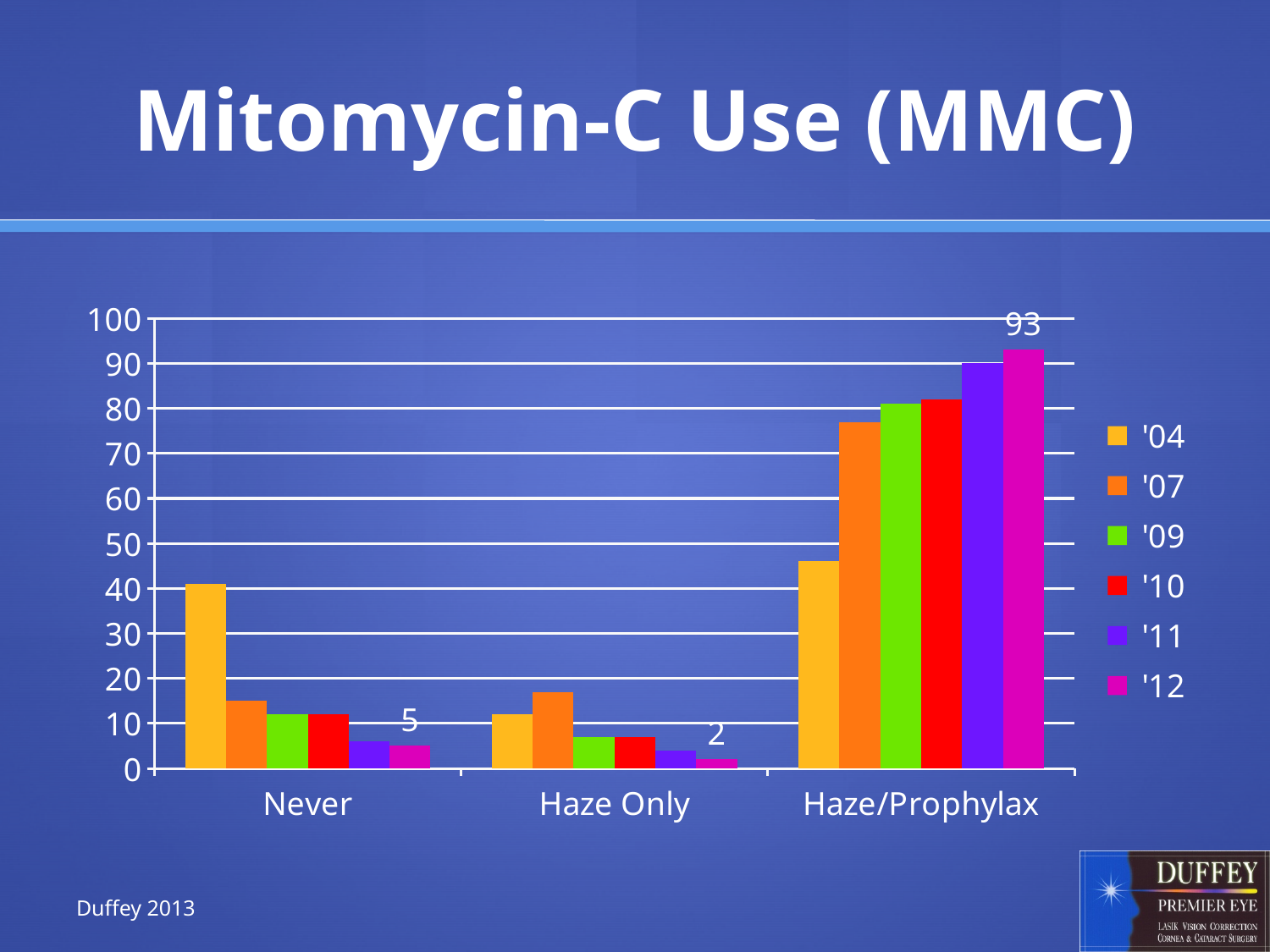
Which year has the highest value in the Haze/Prophylax category? '12 How many categories are shown on the x axis? 3 What is the difference between the '12 values for Haze/Prophylax and Never? 88 Do the values in the Haze/Prophylax category rise or fall from '04 to '12? rise Is the value for '07 in the Never category greater or less than 10? greater What is the value for '12 in the Haze/Prophylax category? 93 Which year has the highest value in the Never category? '04 What is the value for '12 in the Haze Only category? 2 Is the value for '04 in the Haze/Prophylax category greater or less than 40? greater Which year has the lowest value in the Haze Only category? '12 What is the value for '12 in the Never category? 5 How many series does the legend list? 6